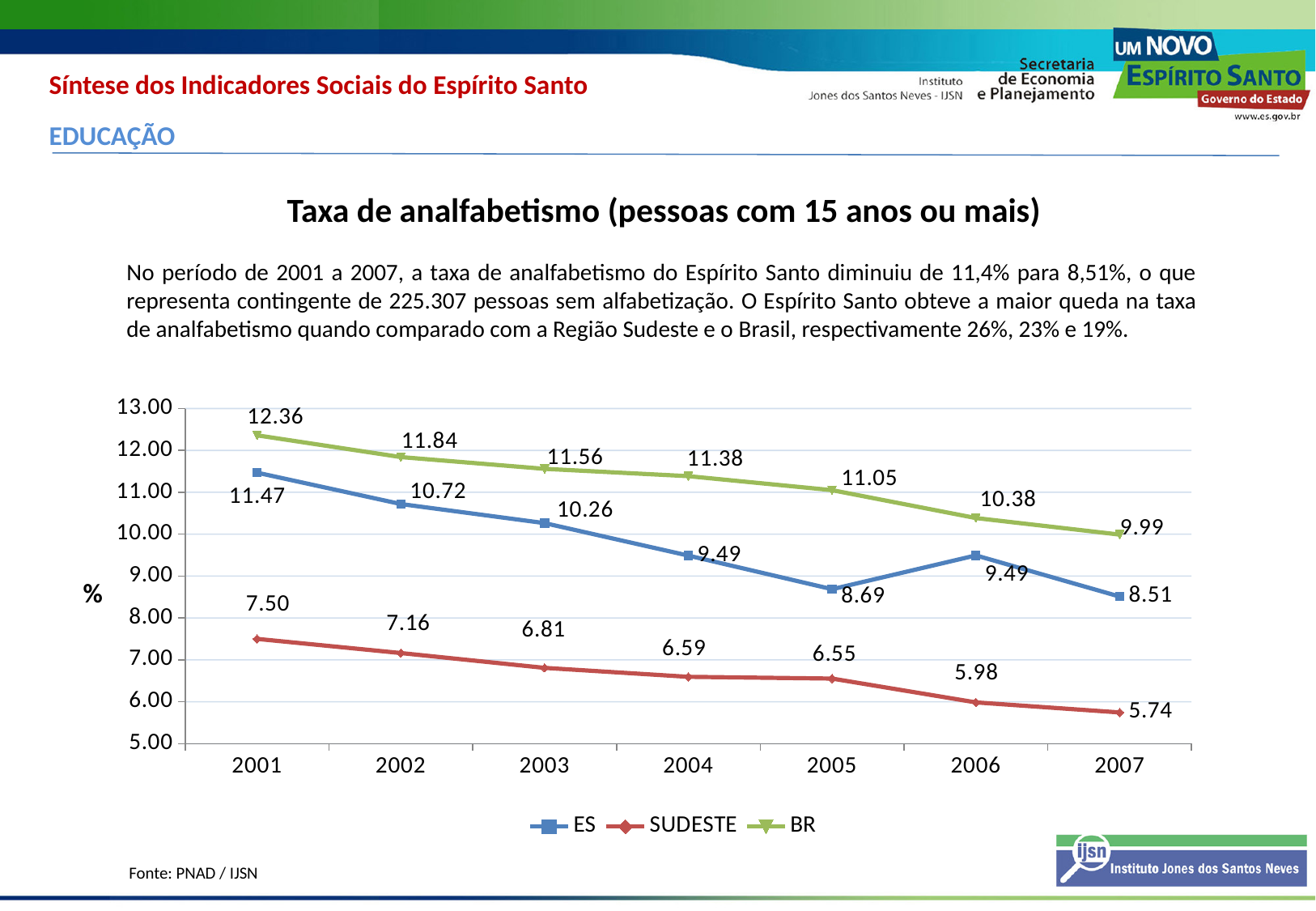
What is the title of the chart? Taxa de analfabetismo (pessoas com 15 anos ou mais) What is the value for ES in 2001? 11.47 What type of chart is shown on the slide? line chart Which is larger in 2005: the value for ES or the value for BR? BR How many years are shown on the x axis? 7 What is the difference between the ES value in 2001 and the ES value in 2007? 2.96 What is the value for SUDESTE in 2004? 6.59 What is the value for BR in 2007? 9.99 In which year is the SUDESTE series lowest? 2007 In which year is the BR series highest? 2001 Does the SUDESTE series rise or fall from 2001 to 2007? fall How many series does the legend list? 3